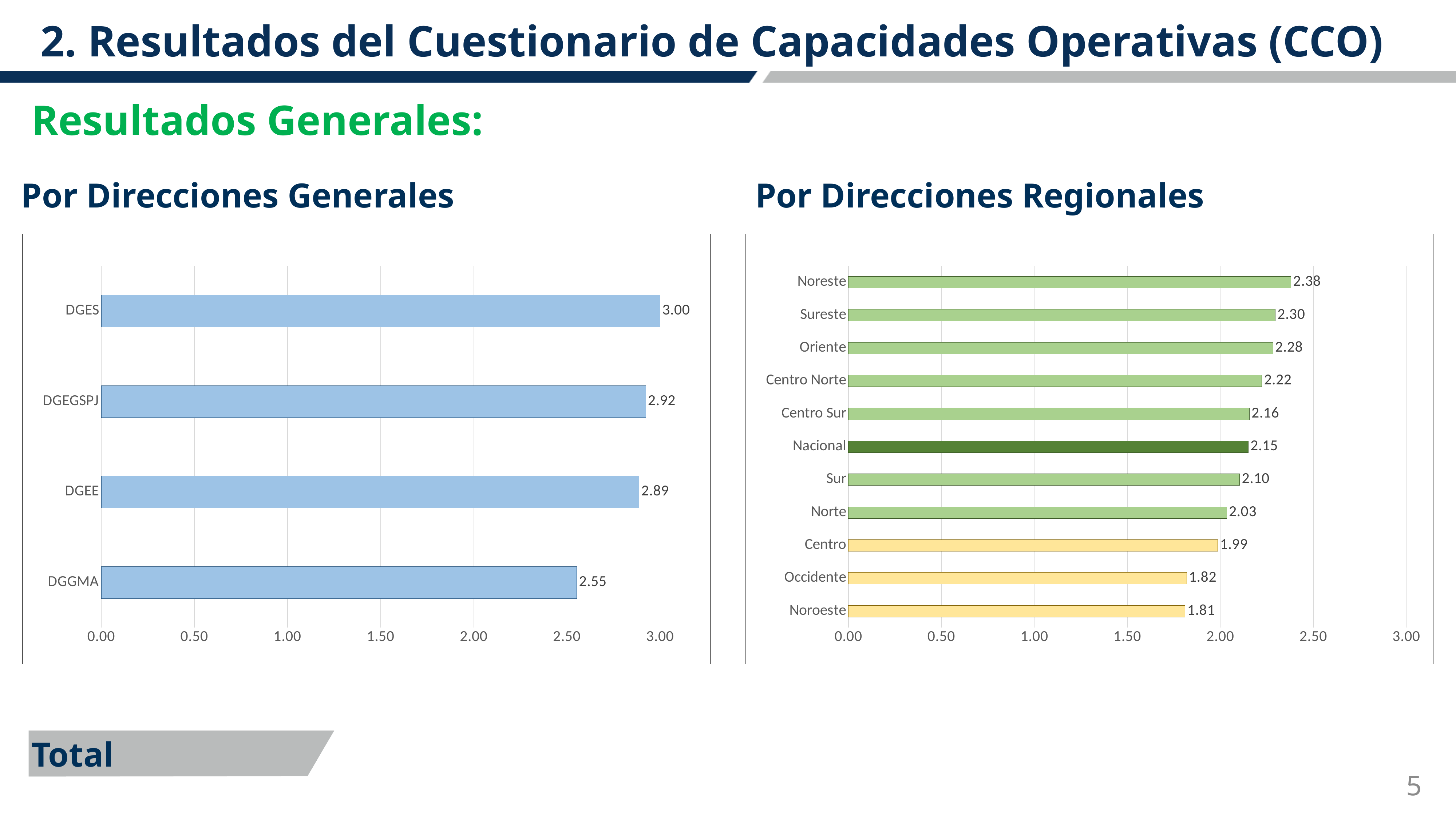
In the 'Por Direcciones Regionales' chart, which category has the highest value? Noreste In the 'Por Direcciones Regionales' chart, how many categories are shown? 11 In the 'Por Direcciones Regionales' chart, what is the value for Centro Norte? 2.22 In the 'Por Direcciones Generales' chart, what is the difference between the values for DGES and DGGMA? 0.45 In the 'Por Direcciones Generales' chart, which category has the lowest value? DGGMA In the 'Por Direcciones Regionales' chart, which is larger, the value for Sur or the value for Centro? Sur In the 'Por Direcciones Regionales' chart, which category's bar is shown in dark green? Nacional In the 'Por Direcciones Generales' chart, how many categories are shown? 4 In the 'Por Direcciones Regionales' chart, which category has the lowest value? Noroeste In the 'Por Direcciones Generales' chart, what is the value for DGEGSPJ? 2.92 What kind of chart is the 'Por Direcciones Regionales' chart? Bar chart In the 'Por Direcciones Regionales' chart, what is the difference between the values for Noreste and Nacional? 0.23